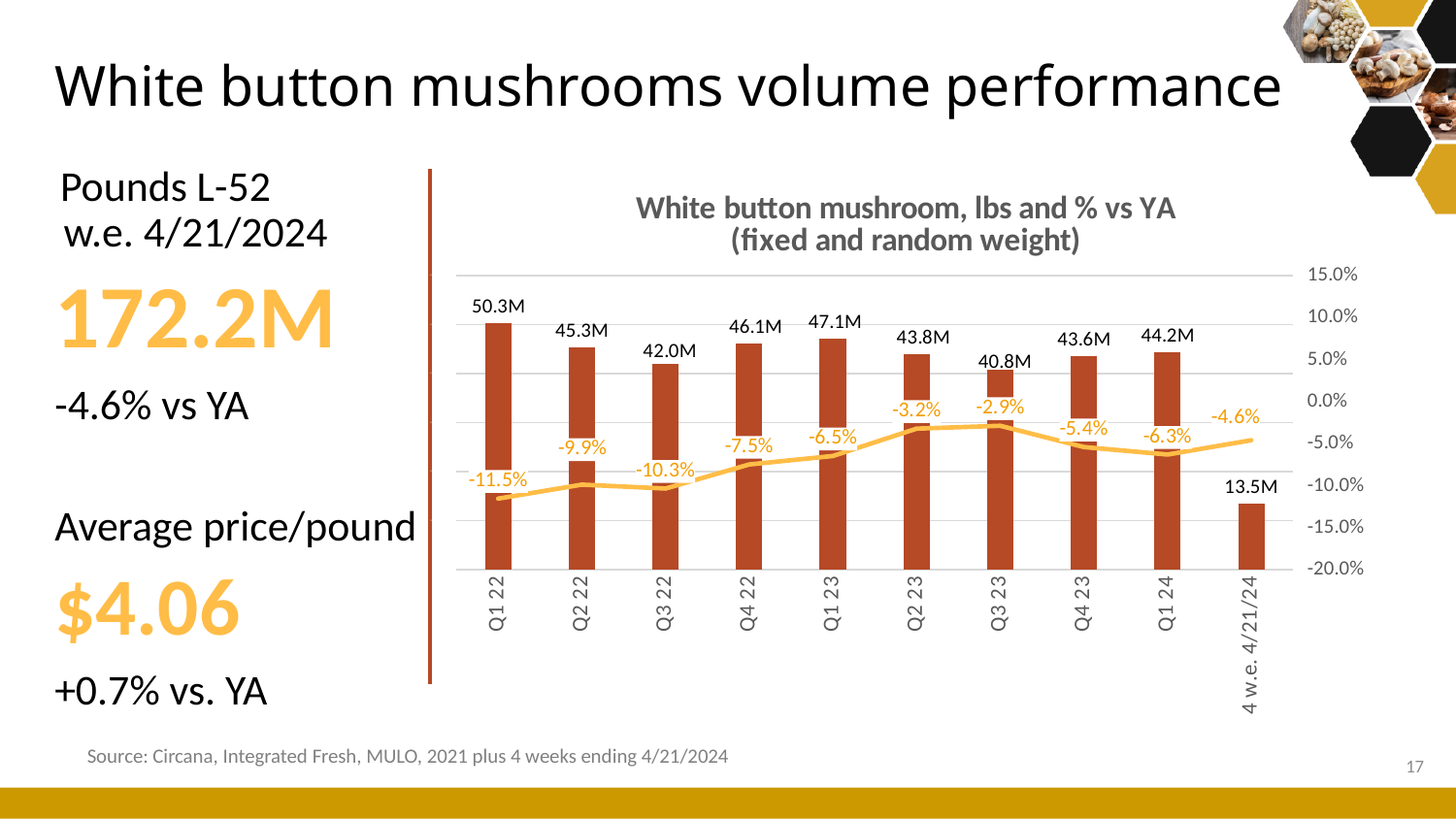
Which has a higher lbs value, Q4 22 or Q4 23? Q4 22 What is the difference in lbs between Q1 23 and Q2 23? 3.3M What kind of chart is this? Combined bar and line chart What is the lbs value for Q1 22? 50.3M What is the title of the chart? White button mushroom, lbs and % vs YA (fixed and random weight) Which quarter has the highest lbs value? Q1 22 What is the % vs YA value for Q3 23? -2.9% Does the % vs YA line generally rise or fall from Q1 22 to Q3 23? Rise What is the % vs YA value for Q2 22? -9.9% How many categories are shown on the x axis? 10 Which category has the lowest % vs YA value? Q1 22 What is the lbs value for the 4 w.e. 4/21/24 period? 13.5M